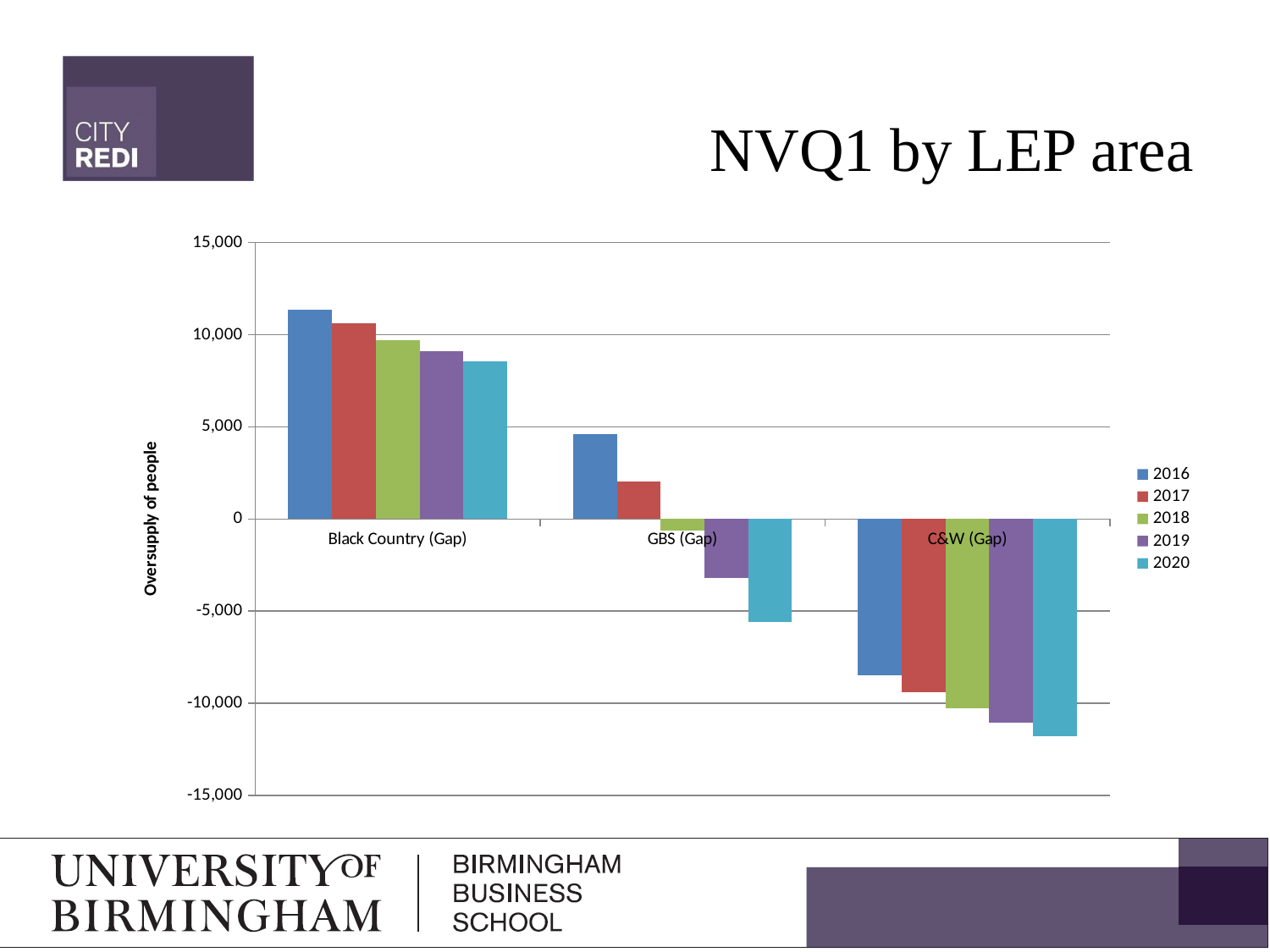
How many series does the legend list? 5 Which LEP area has the lowest 2020 value? C&W (Gap) What kind of chart is shown on the slide? bar chart Is the 2016 value for GBS (Gap) greater or less than 5,000? less Is the 2020 value for GBS (Gap) greater or less than -5,000? less What is the title of the chart? NVQ1 by LEP area For Black Country (Gap), do the values rise or fall from 2016 to 2020? fall Which is larger, the 2017 value for Black Country (Gap) or the 2017 value for GBS (Gap)? Black Country (Gap) Is the 2020 value for C&W (Gap) greater or less than -10,000? less How many LEP area categories are shown on the x axis? 3 What is the label on the vertical axis? Oversupply of people